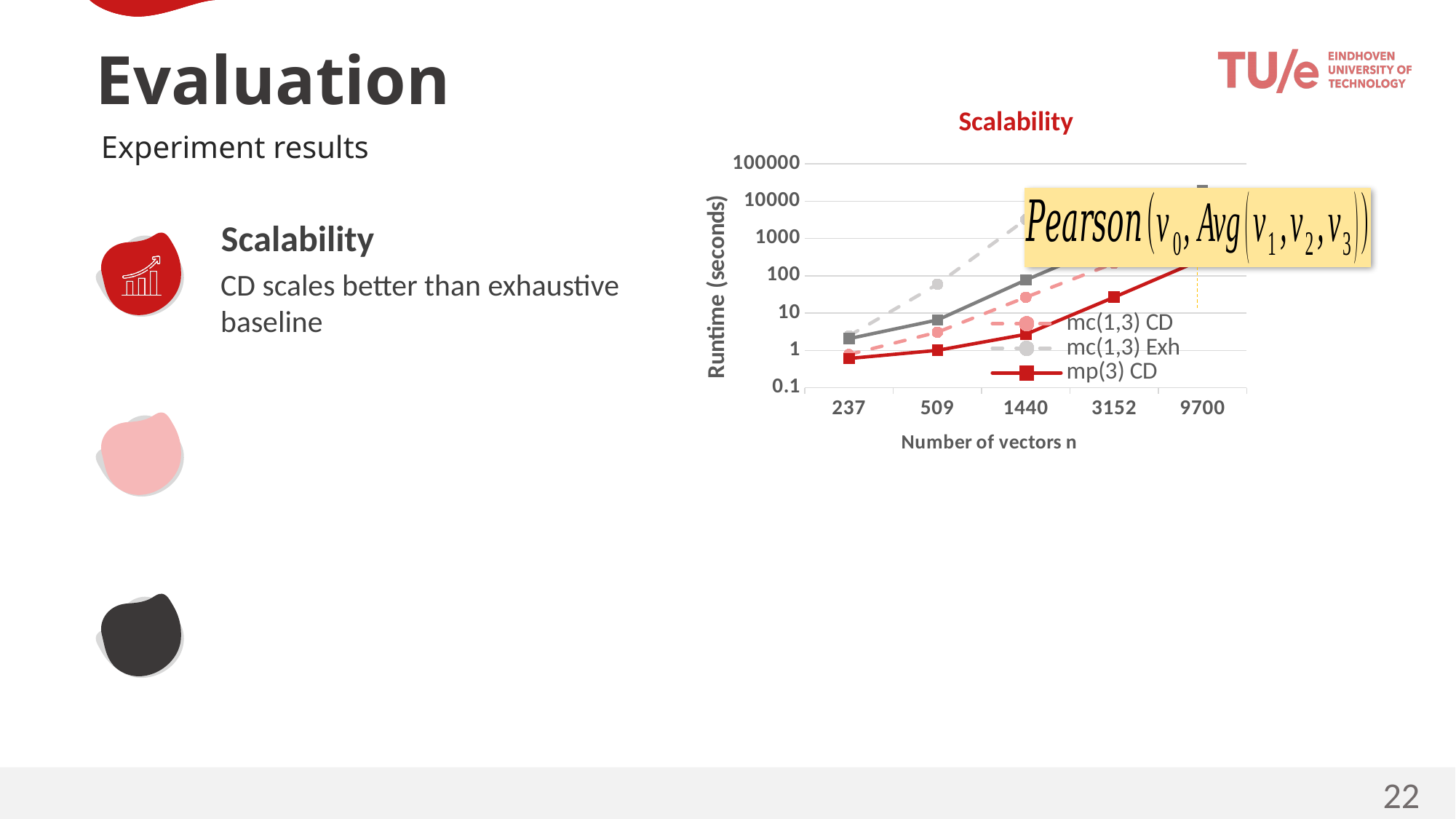
Is the runtime for mc(1,3) CD at n = 1440 greater or less than 10? greater At n = 509, which series has the lowest runtime? mp(3) CD At n = 1440, which has the larger runtime: mc(1,3) Exh or mp(3) CD? mc(1,3) Exh What is the x-axis label of the Scalability chart? Number of vectors n How many values of n are shown on the x axis of the Scalability chart? 5 Is the runtime for mp(3) CD at n = 237 greater or less than 1? less Does the runtime of mp(3) CD rise or fall as the number of vectors n increases? rise Is the runtime for mc(1,3) Exh at n = 509 greater or less than 10? greater At n = 509, which series has the highest runtime? mc(1,3) Exh What kind of chart is the Scalability chart? line chart What is the title of the chart? Scalability